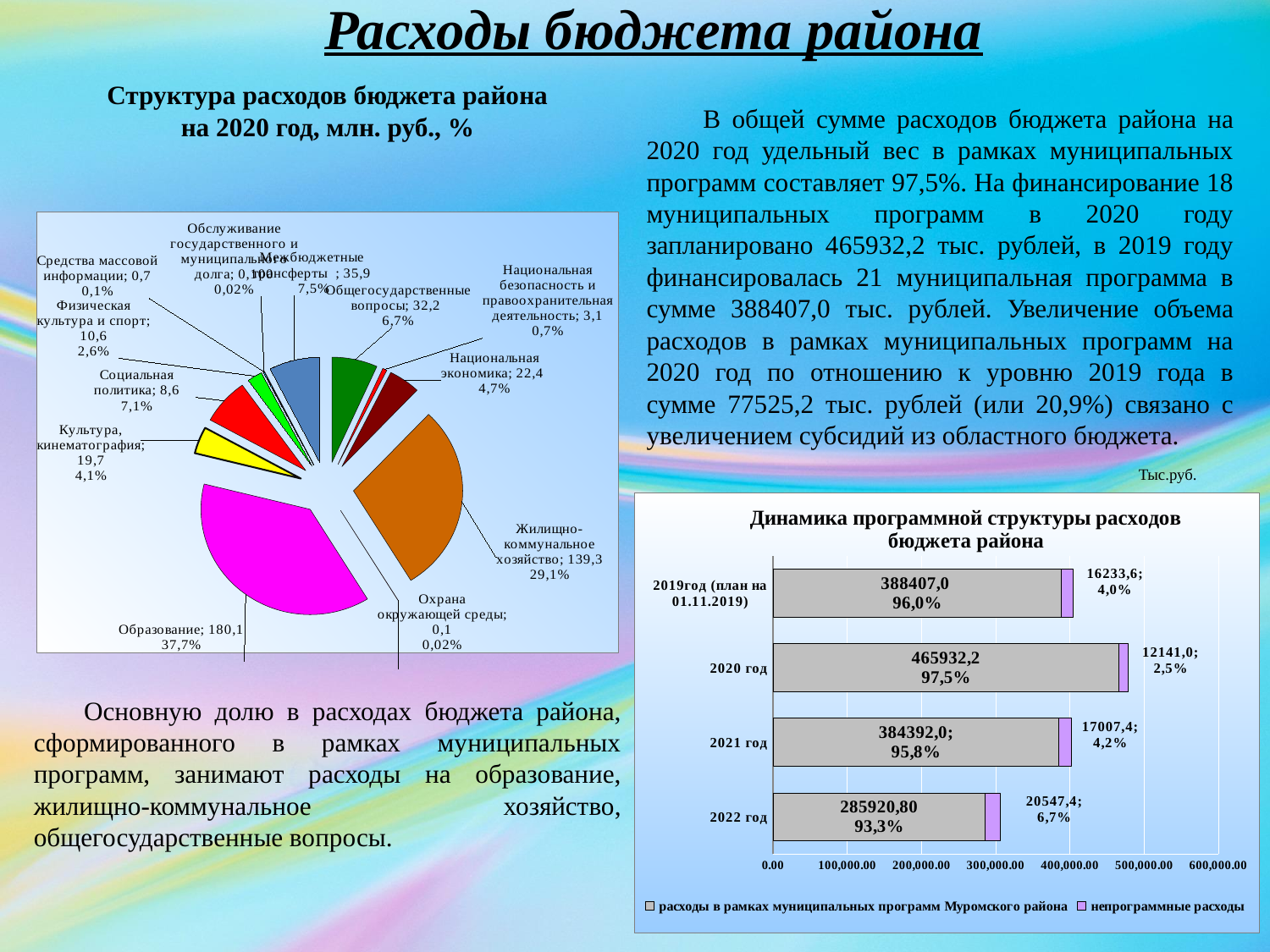
In the pie chart 'Структура расходов бюджета района на 2020 год', what percentage share is shown for Жилищно-коммунальное хозяйство? 29,1% In the pie chart 'Структура расходов бюджета района на 2020 год', which category has the largest slice? Образование In the pie chart 'Структура расходов бюджета района на 2020 год', what value is shown for Образование? 180,1 In the chart 'Динамика программной структуры расходов бюджета района', how many series does the legend list? 2 In the pie chart 'Структура расходов бюджета района на 2020 год', which is larger: Общегосударственные вопросы or Национальная экономика? Общегосударственные вопросы In the pie chart 'Структура расходов бюджета района на 2020 год', how many categories are shown? 12 In the chart 'Динамика программной структуры расходов бюджета района', what value is shown for непрограммные расходы in 2022 год? 20547,4 In the chart 'Динамика программной структуры расходов бюджета района', what percentage is shown for расходы в рамках муниципальных программ in 2021 год? 95,8% What type of chart is 'Динамика программной структуры расходов бюджета района'? Bar chart In the chart 'Динамика программной структуры расходов бюджета района', which year has the highest value for расходы в рамках муниципальных программ? 2020 год In the chart 'Динамика программной структуры расходов бюджета района', what value is shown for расходы в рамках муниципальных программ in 2020 год? 465932,2 In the pie chart 'Структура расходов бюджета района на 2020 год', what value is shown for Межбюджетные трансферты? 35,9